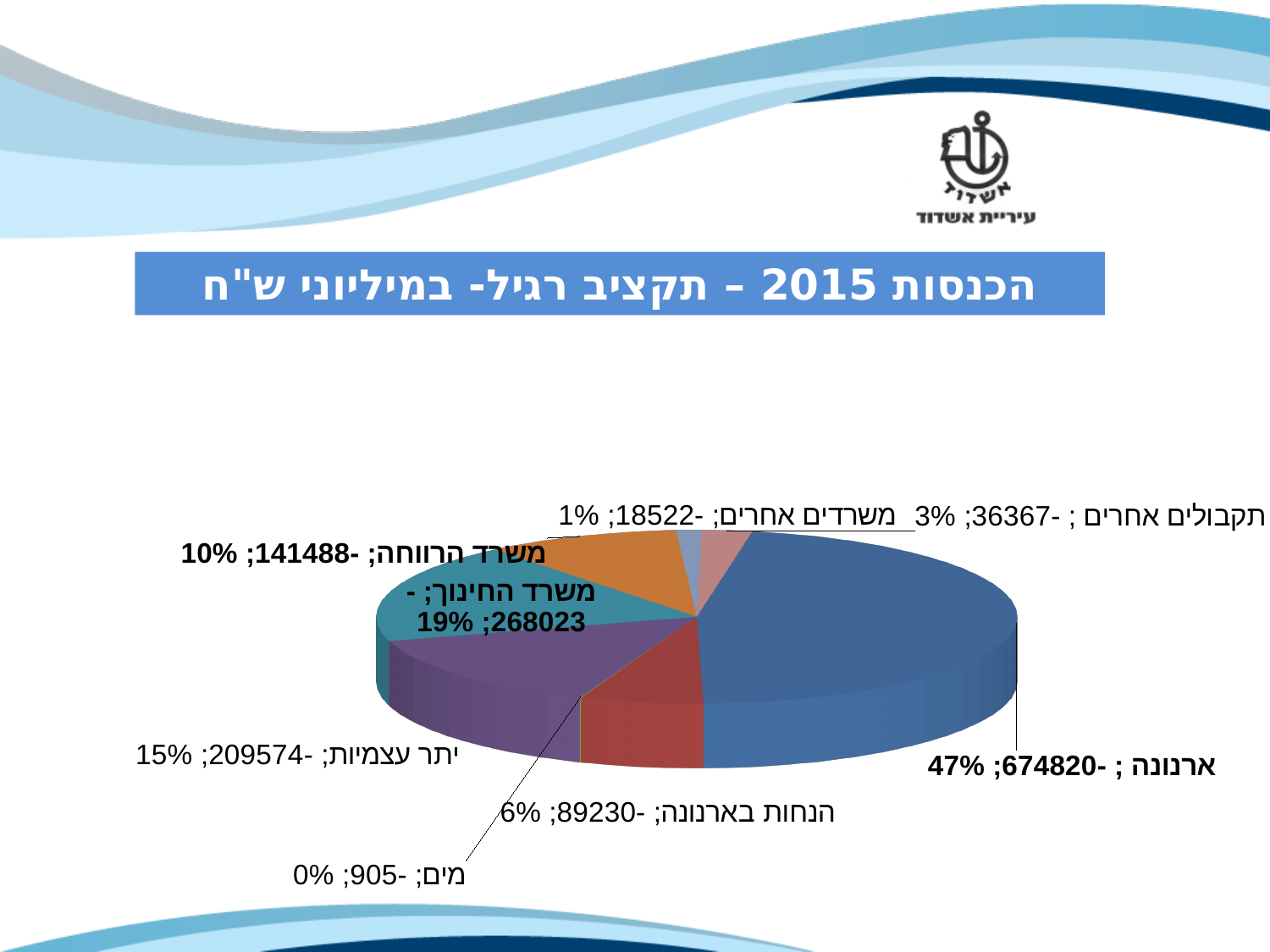
What percentage share does the משרד החינוך slice have? 19% How many slices does the pie chart have? 8 Which category has the largest share of the pie? ארנונה What value is shown for הנחות בארנונה? -89230 What value is shown for יתר עצמיות? -209574 Which has a larger share: משרד החינוך or יתר עצמיות? משרד החינוך What percentage share does the ארנונה slice have? 47% What is the title of the chart on the slide? הכנסות 2015 – תקציב רגיל- במיליוני ש"ח What is the difference in percentage points between the ארנונה share and the משרד החינוך share? 28 What kind of chart is shown on the slide? pie chart Which category has the smallest share of the pie? מים What value is shown for משרד הרווחה? -141488